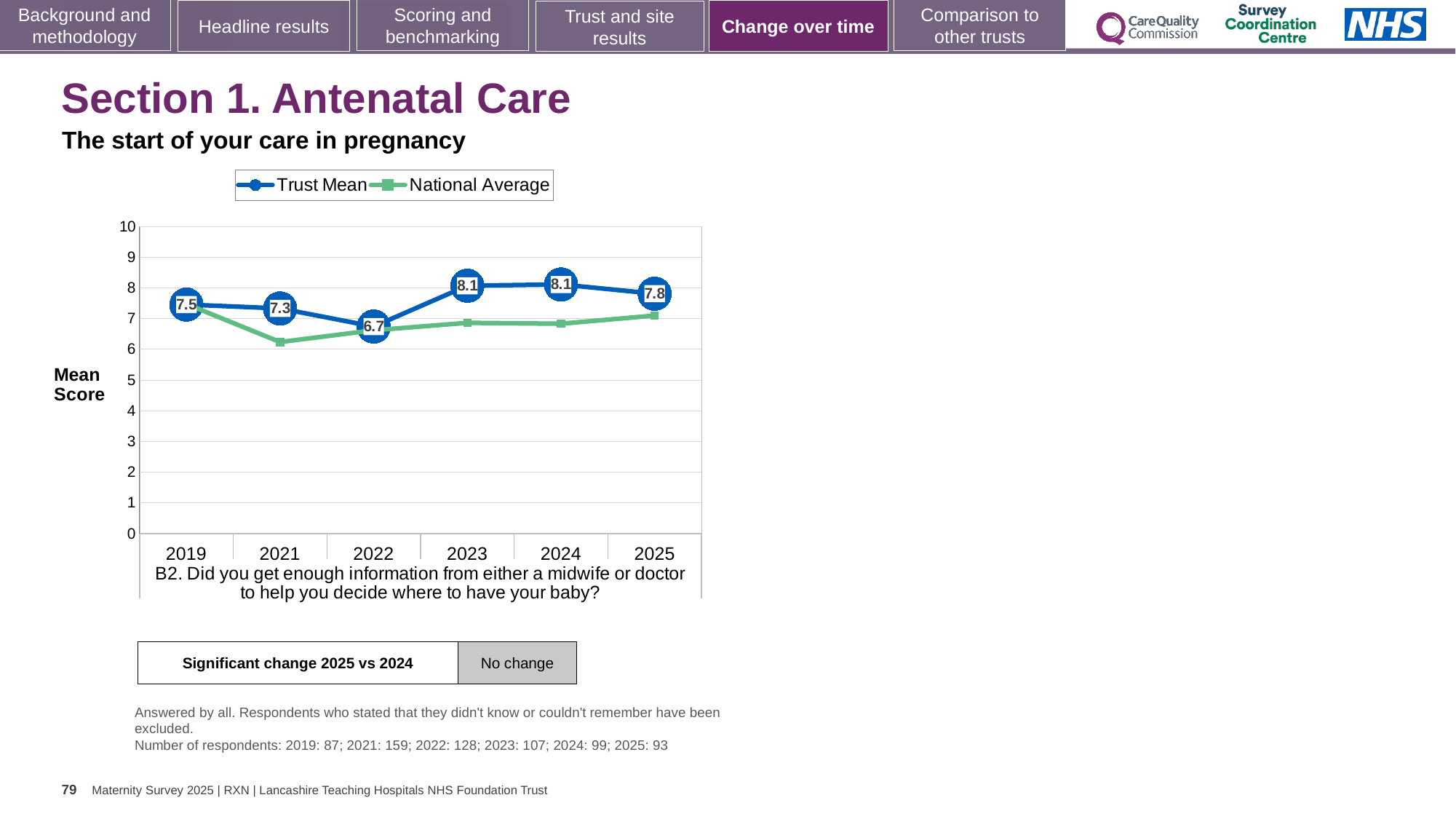
How many years are shown on the x axis? 6 Which is larger, the Trust Mean score for 2021 or for 2025? 2025 What is the Trust Mean score for 2025? 7.8 Does the Trust Mean score rise or fall from 2024 to 2025? Fall What kind of chart is shown on the slide? Line chart In which year is the Trust Mean score lowest? 2022 Is the National Average value for 2021 greater or less than 7? less What is the Trust Mean score for 2019? 7.5 Is the National Average value for 2022 greater or less than 7? less What is the difference between the Trust Mean scores for 2023 and 2022? 1.4 How many series does the legend list? 2 What is the Trust Mean score for 2022? 6.7